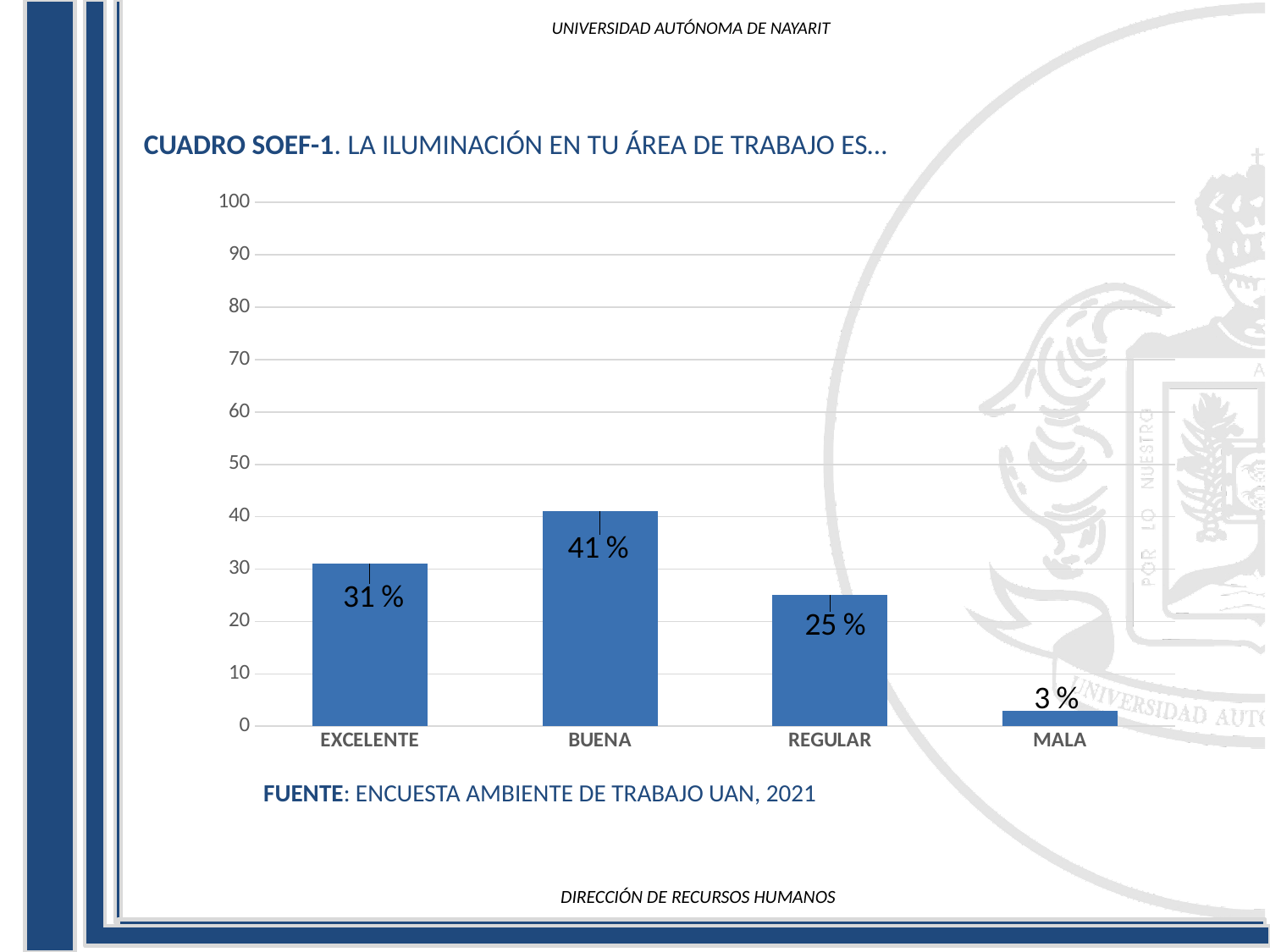
What is the value for EXCELENTE? 31 % What kind of chart is shown on the slide? bar chart How many categories are shown on the x axis? 4 What is the difference between the values for BUENA and EXCELENTE? 10 % What is the value for MALA? 3 % Which is larger, the value for EXCELENTE or the value for REGULAR? EXCELENTE What is the value for REGULAR? 25 % Is the value for BUENA greater or less than 50? less Which category has the lowest value? MALA Which category has the highest value? BUENA What is the value for BUENA? 41 % What is the difference between the values for REGULAR and MALA? 22 %